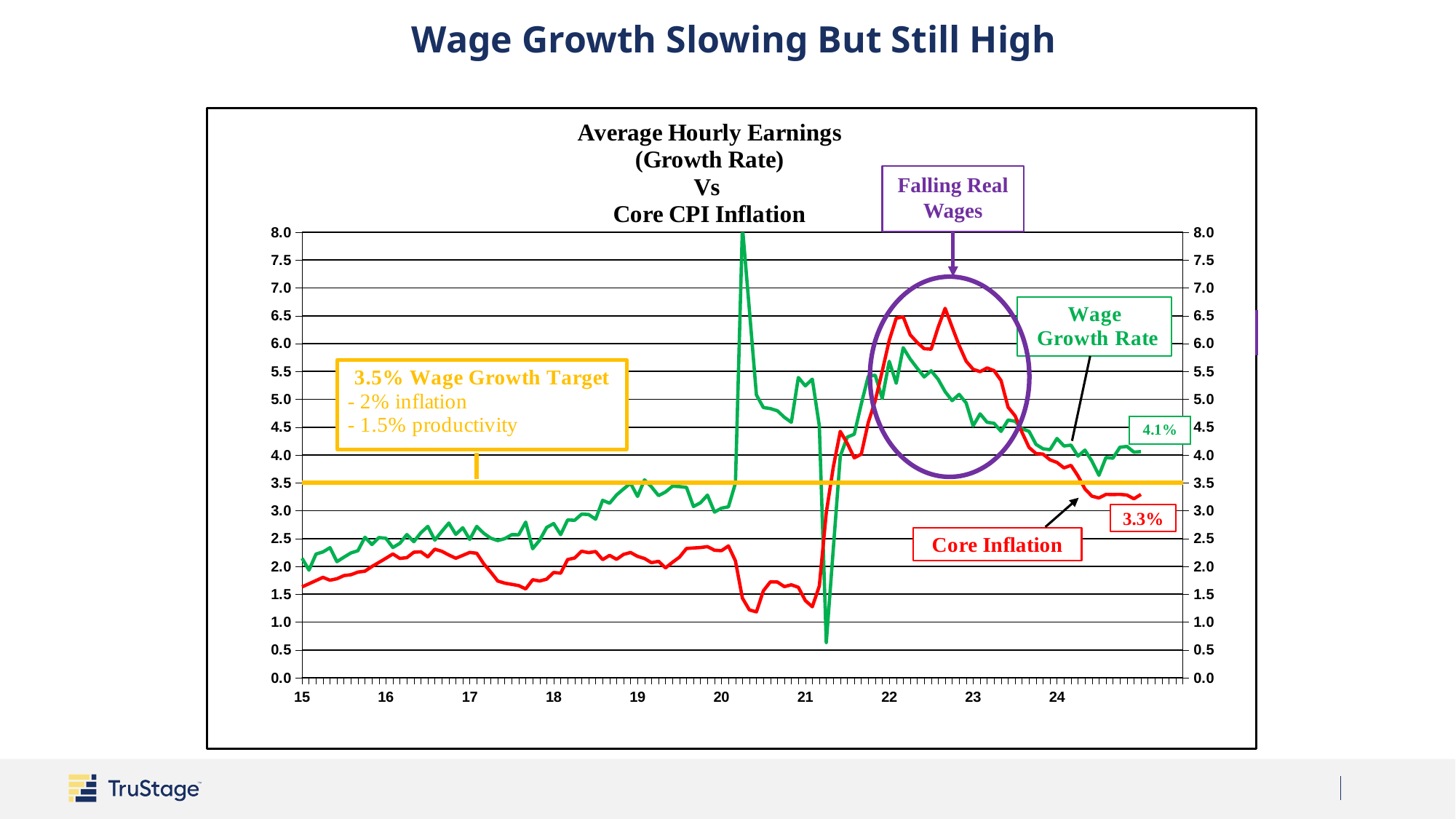
What value is the horizontal yellow line marking the wage growth target? 3.5% What is the title of the chart? Average Hourly Earnings (Growth Rate) Vs Core CPI Inflation What is the latest labelled value of the Core Inflation line? 3.3% What is the latest labelled value of the Wage Growth Rate line? 4.1% Is the latest Core Inflation value of 3.3% greater or less than the 3.5% wage growth target? less Which series reaches the lowest point on the chart? Wage Growth Rate What is the difference between the latest labelled Wage Growth Rate (4.1%) and the latest labelled Core Inflation (3.3%)? 0.8% What does the purple annotation pointing to the circled area of the chart say? Falling Real Wages Is the peak of the Wage Growth Rate line around 2020 greater or less than 7.0? greater What kind of chart is shown on the slide? line chart Which is larger at the end of the chart, the Wage Growth Rate or Core Inflation? Wage Growth Rate Which series reaches the highest point on the chart? Wage Growth Rate